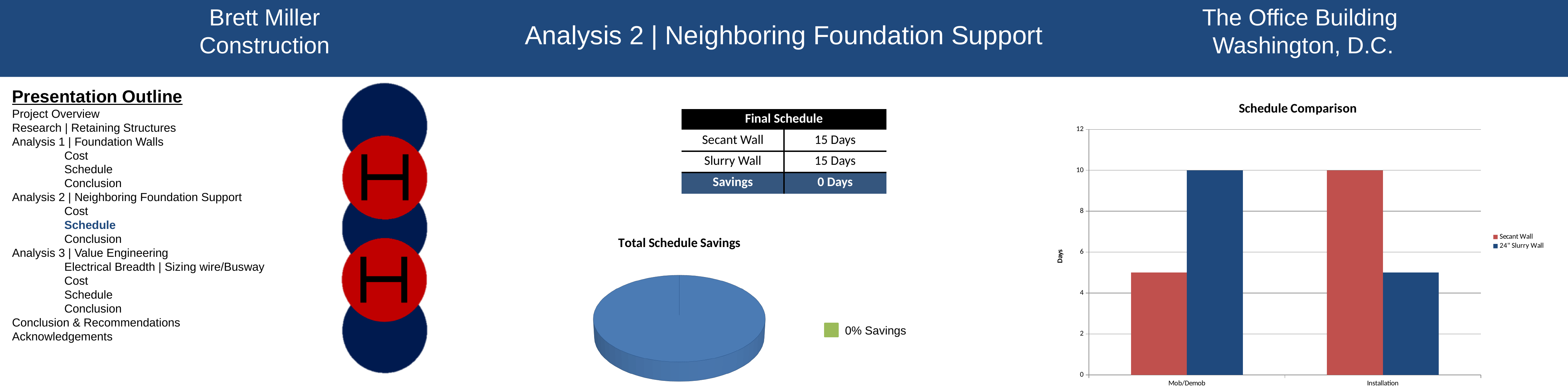
In the 'Total Schedule Savings' chart, what does the legend entry say? 0% Savings In the 'Schedule Comparison' chart, is the value for Secant Wall at Mob/Demob greater or less than 6? less What kind of chart is the 'Schedule Comparison' chart? bar chart In the 'Schedule Comparison' chart, how many series does the legend list? 2 In the 'Schedule Comparison' chart, how many categories are shown on the x axis? 2 In the 'Schedule Comparison' chart, what is the value for 24" Slurry Wall at Mob/Demob? 10 In the 'Schedule Comparison' chart, which series has the larger value at Installation? Secant Wall In the 'Schedule Comparison' chart, is the value for 24" Slurry Wall at Installation greater or less than 4? greater In the 'Schedule Comparison' chart, what is the value for Secant Wall at Installation? 10 In the 'Schedule Comparison' chart, what is the label on the y axis? Days What kind of chart is the 'Total Schedule Savings' chart? pie chart In the 'Schedule Comparison' chart, which series has the larger value at Mob/Demob? 24" Slurry Wall